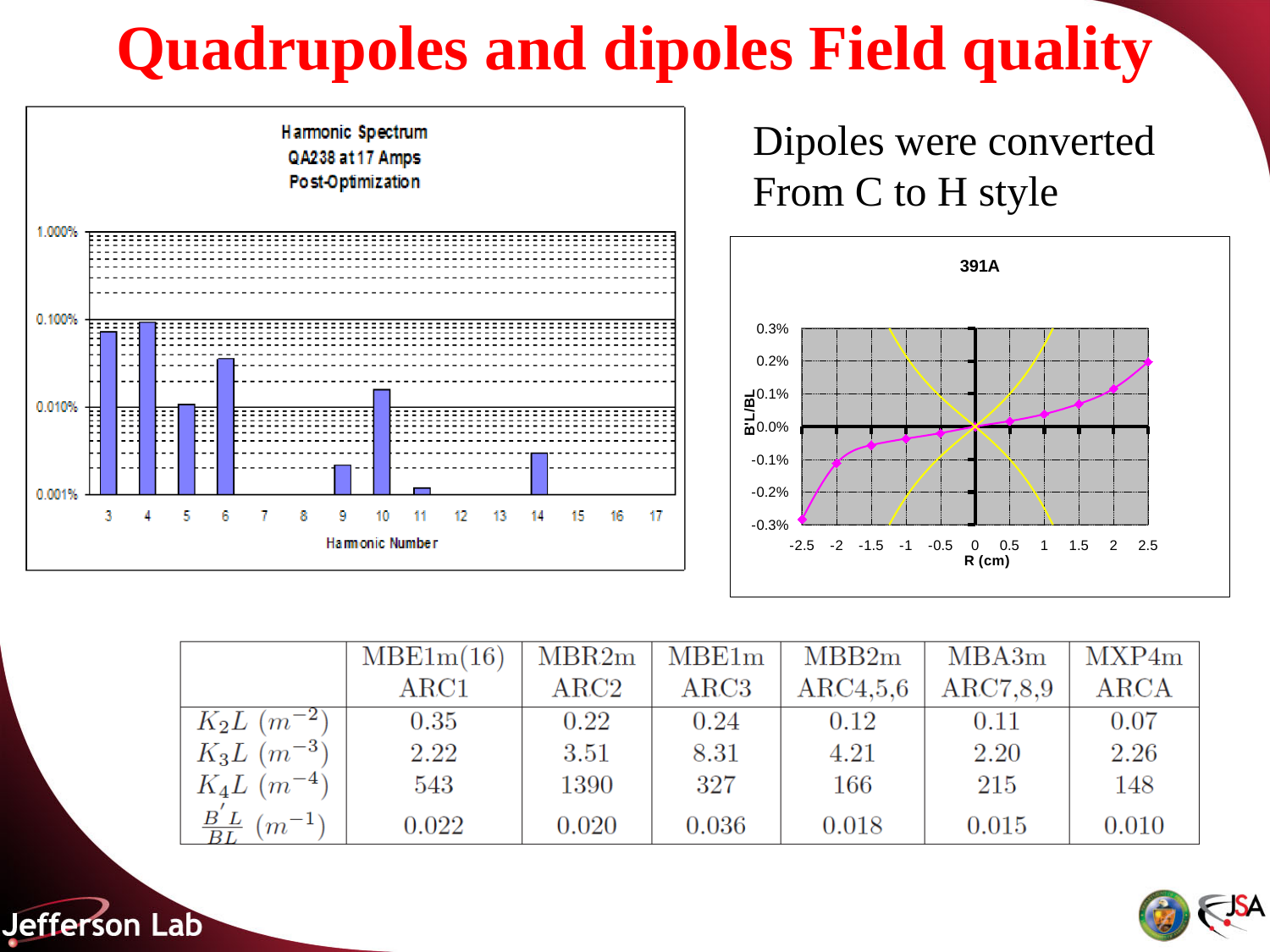
What is the x-axis label of the 391A chart on the right? R (cm) In the Harmonic Spectrum chart, which harmonic number has the highest bar? 4 In the Harmonic Spectrum chart, is the value for harmonic number 3 greater or less than 0.010%? greater In the Harmonic Spectrum chart, which is larger, the value for harmonic number 10 or harmonic number 9? harmonic number 10 In the Harmonic Spectrum chart, which is larger, the value for harmonic number 4 or harmonic number 6? harmonic number 4 How many harmonic numbers are labelled on the x axis of the Harmonic Spectrum chart? 15 In the Harmonic Spectrum chart, is the value for harmonic number 6 greater or less than 0.010%? greater In the Harmonic Spectrum chart, is the value for harmonic number 9 greater or less than 0.010%? less In the Harmonic Spectrum chart, which harmonic number has the lowest visible bar? 11 What type of chart is the Harmonic Spectrum chart on the left? bar chart In the 391A chart, does the magenta curve rise or fall as R increases from -2.5 to 2.5? rise